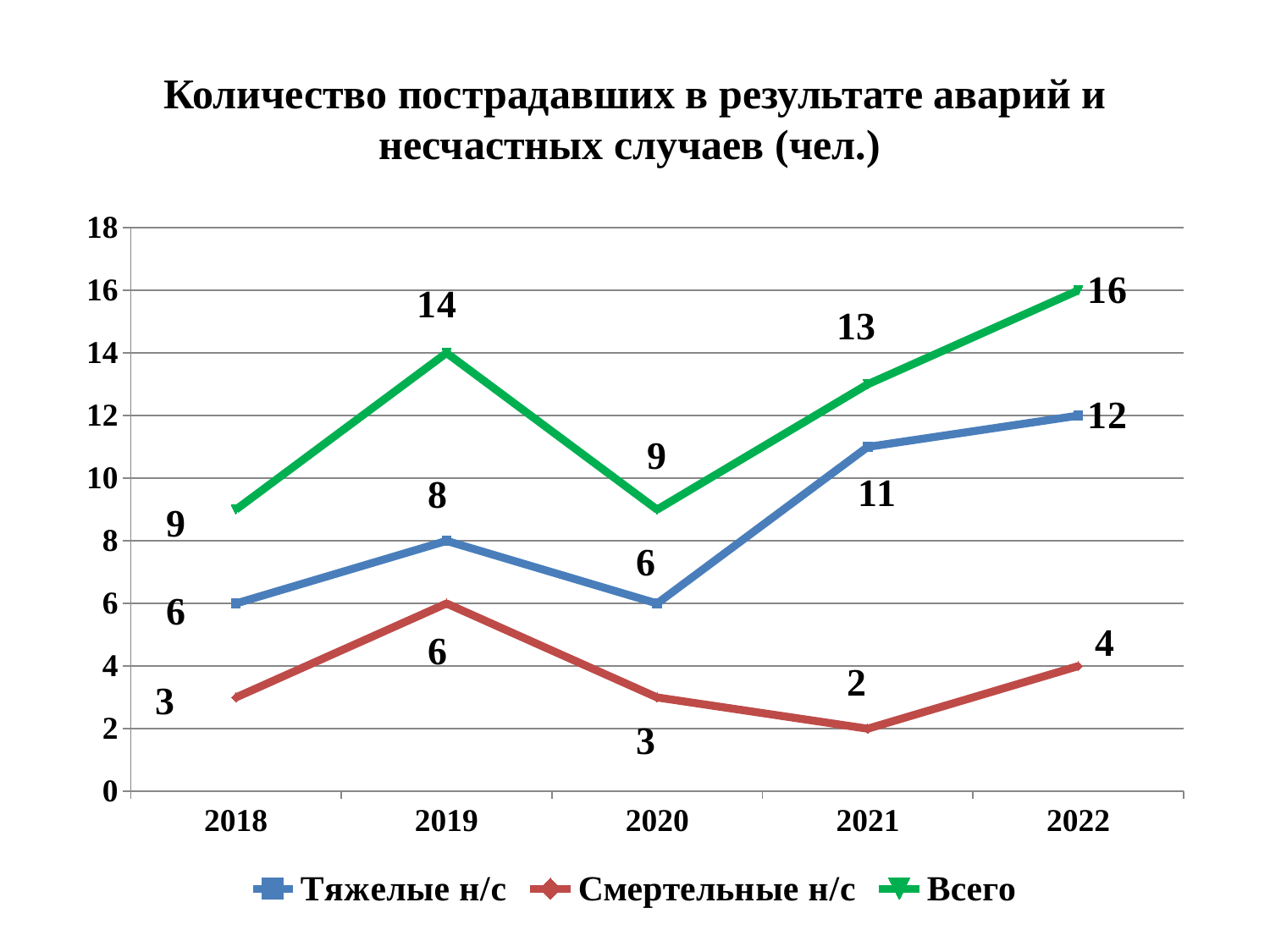
In which year is Тяжелые н/с the highest? 2022 How many series does the legend list? 3 What is the value of Всего in 2022? 16 What kind of chart is shown on the slide? Line chart In which year is Всего the lowest? 2018 and 2020 What is the value of Смертельные н/с in 2019? 6 How many years are plotted on the x axis? 5 What is the difference between Всего in 2019 and Всего in 2020? 5 In which year is Смертельные н/с the lowest? 2021 What is the value of Тяжелые н/с in 2021? 11 Which is larger: Тяжелые н/с in 2020 or Смертельные н/с in 2020? Тяжелые н/с Does Всего rise or fall from 2020 to 2022? Rise